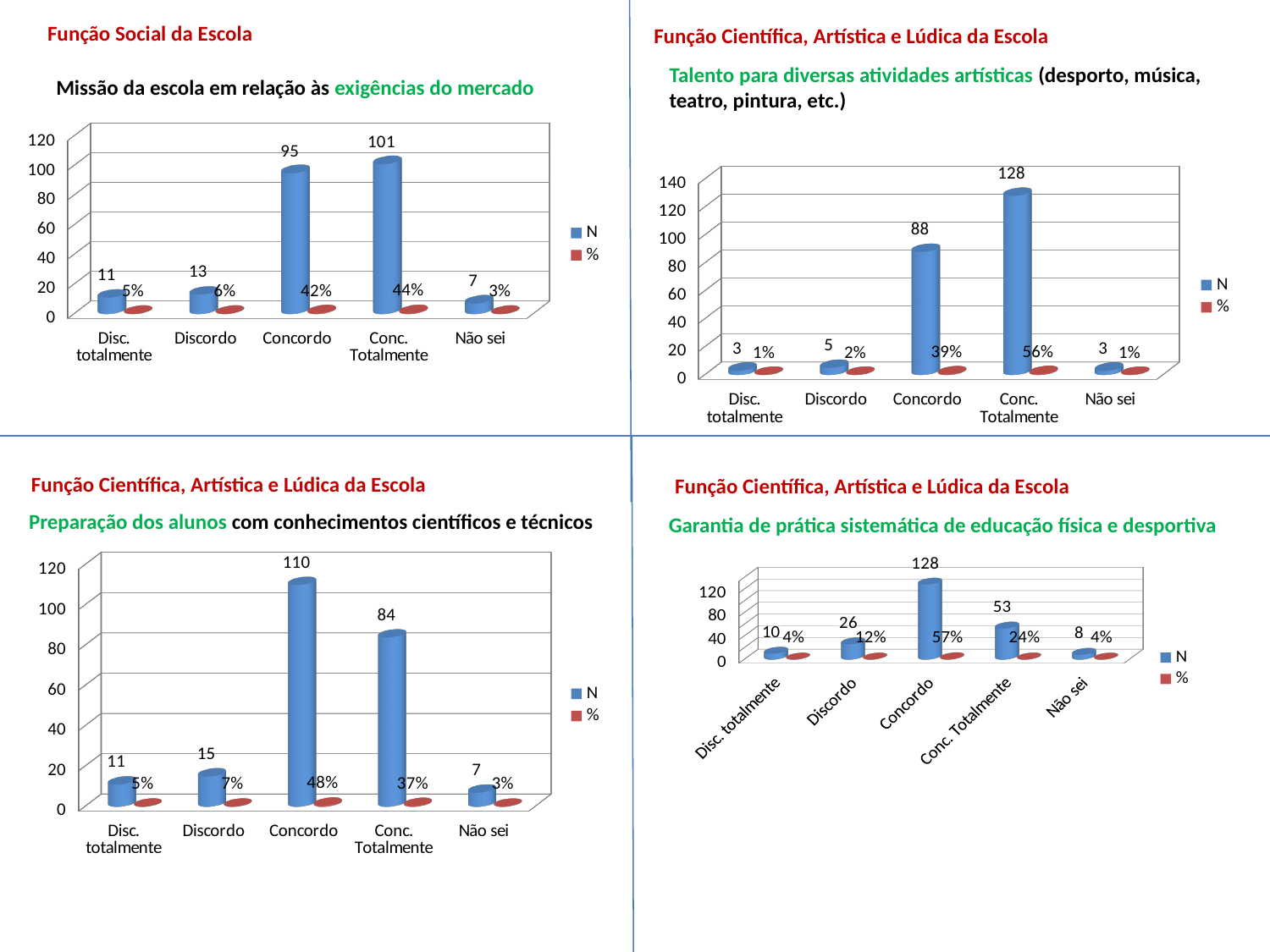
In the bottom-right chart (Garantia de prática sistemática de educação física e desportiva), what is the N value for Conc. Totalmente? 53 In the top-right chart (Talento para diversas atividades artísticas), what percentage is shown for Conc. Totalmente? 56% In the bottom-left chart (Preparação dos alunos com conhecimentos científicos e técnicos), which is larger, the N value for Concordo or for Conc. Totalmente? Concordo In the top-left chart (Missão da escola em relação às exigências do mercado), what is the N value for Conc. Totalmente? 101 In the bottom-right chart (Garantia de prática sistemática de educação física e desportiva), what percentage is shown for Discordo? 12% In the top-left chart (Missão da escola em relação às exigências do mercado), what is the difference between the N values for Conc. Totalmente and Concordo? 6 In the bottom-left chart (Preparação dos alunos com conhecimentos científicos e técnicos), what is the N value for Concordo? 110 In the top-right chart (Talento para diversas atividades artísticas), which category has the highest N value? Conc. Totalmente How many series does the legend of the top-left chart (Missão da escola em relação às exigências do mercado) list? 2 How many categories are shown on the x axis of the bottom-right chart (Garantia de prática sistemática de educação física e desportiva)? 5 In the top-right chart (Talento para diversas atividades artísticas), what is the difference between the N values for Conc. Totalmente and Concordo? 40 In the top-left chart (Missão da escola em relação às exigências do mercado), which category has the lowest N value? Não sei